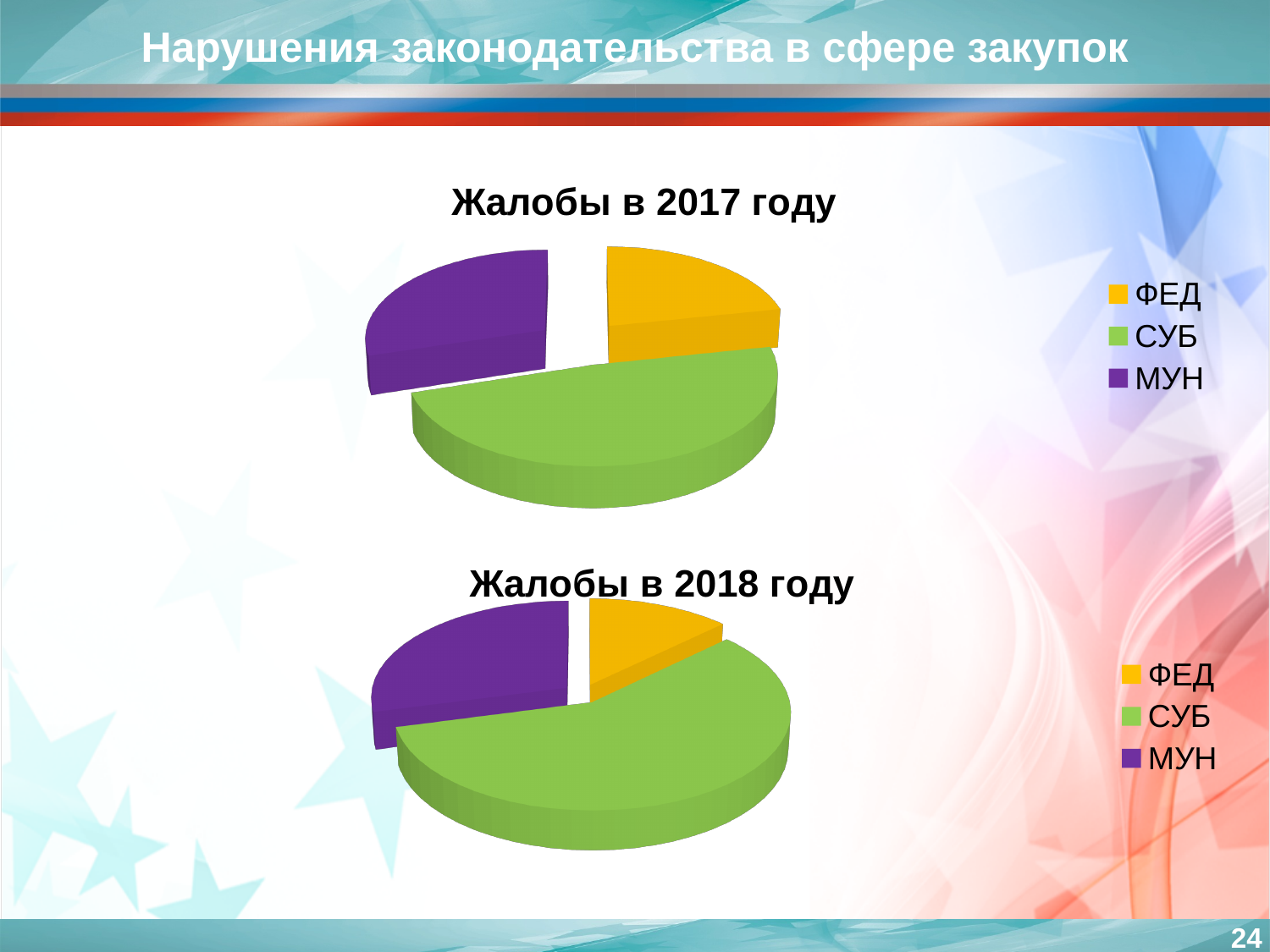
In the chart "Жалобы в 2017 году", which slice is larger, МУН or ФЕД? МУН In the chart "Жалобы в 2018 году", which category has the smallest slice? ФЕД In the chart "Жалобы в 2018 году", what colour is the СУБ slice? Green In the chart "Жалобы в 2018 году", which slice is larger, СУБ or МУН? СУБ In the chart "Жалобы в 2018 году", how many categories does the legend list? 3 What kind of chart is "Жалобы в 2017 году"? Pie chart In the chart "Жалобы в 2017 году", which category has the largest slice? СУБ In the chart "Жалобы в 2017 году", which category has the smallest slice? ФЕД In the chart "Жалобы в 2017 году", how many slices does the pie have? 3 In the chart "Жалобы в 2018 году", which category has the largest slice? СУБ What is the title of the upper chart on the slide? Жалобы в 2017 году What kind of chart is "Жалобы в 2018 году"? Pie chart